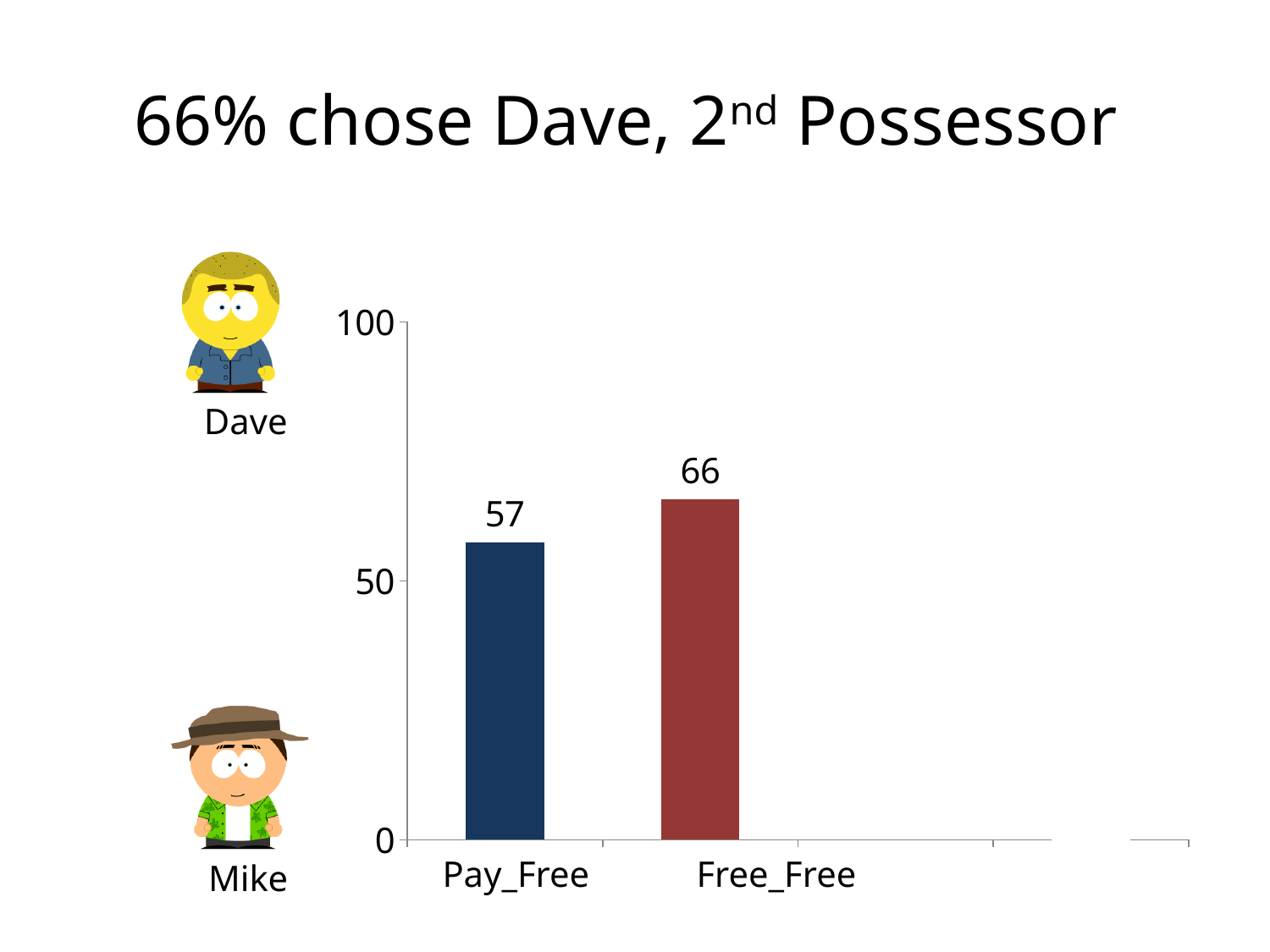
Do the values rise or fall from Pay_Free to Free_Free? rise What is the value for Free_Free? 66 How many categories are shown on the x axis? 2 Is the value for Free_Free greater or less than 100? less Is the value for Pay_Free greater or less than 50? greater Which is larger, the value for Pay_Free or the value for Free_Free? Free_Free Which category has the lowest value? Pay_Free What kind of chart is shown on the slide? bar chart What is the value for Pay_Free? 57 What colour is the bar for Free_Free? red Which category has the highest value? Free_Free What is the difference between the values for Free_Free and Pay_Free? 9